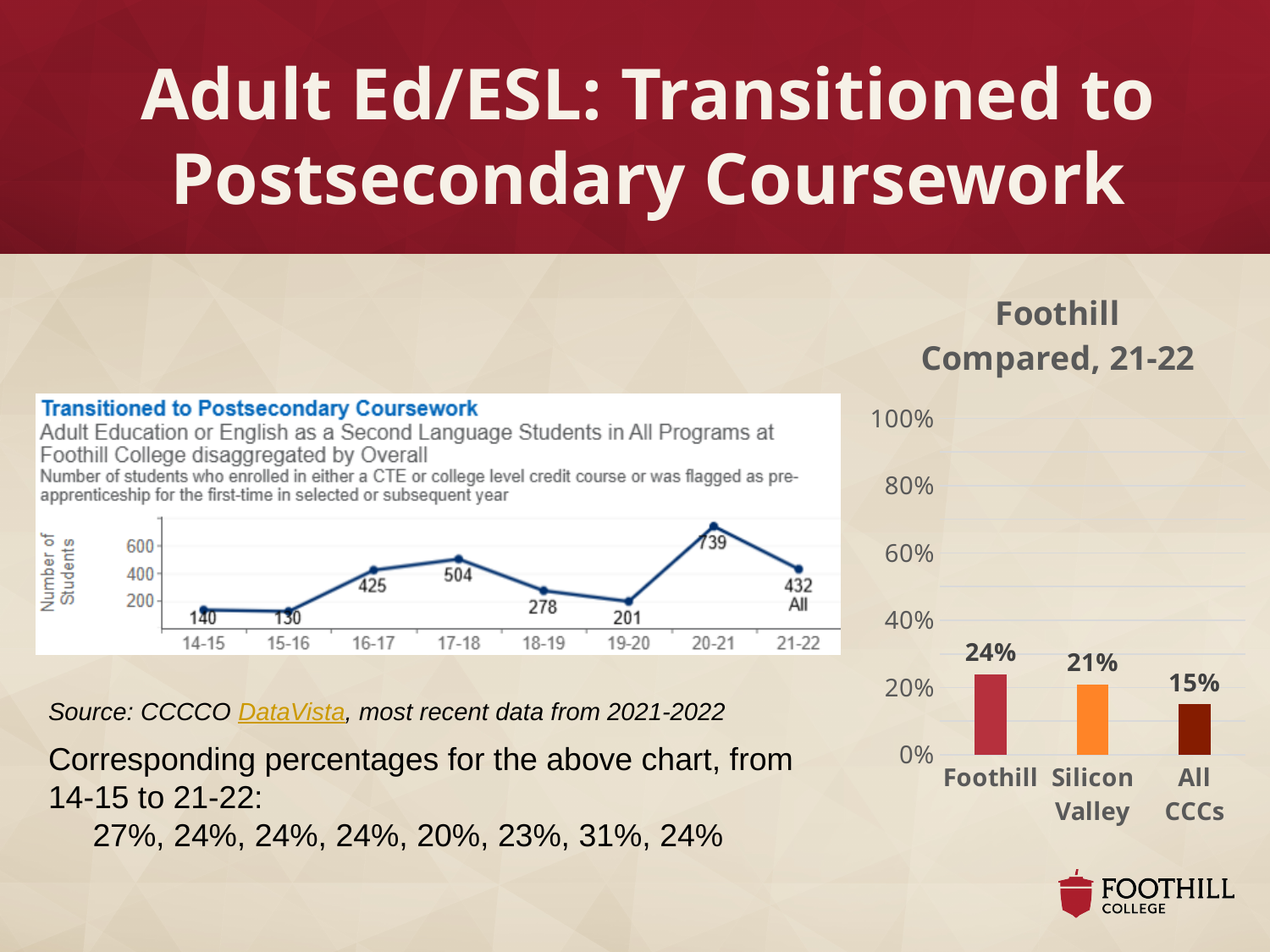
In the 'Foothill Compared, 21-22' chart, which is larger, Foothill or Silicon Valley? Foothill In the 'Transitioned to Postsecondary Coursework' line chart, what is the number of students for 17-18? 504 In the 'Transitioned to Postsecondary Coursework' line chart, which year has the lowest number of students? 15-16 In the 'Transitioned to Postsecondary Coursework' line chart, what is the difference in number of students between 20-21 and 21-22? 307 In the 'Transitioned to Postsecondary Coursework' line chart, what is the number of students for 20-21? 739 In the 'Foothill Compared, 21-22' chart, which category has the lowest value? All CCCs In the 'Transitioned to Postsecondary Coursework' line chart, does the number of students rise or fall from 18-19 to 19-20? fall In the 'Transitioned to Postsecondary Coursework' line chart, how many years are plotted? 8 In the 'Foothill Compared, 21-22' chart, what is the value for Silicon Valley? 21% In the 'Foothill Compared, 21-22' chart, what is the difference between Foothill and All CCCs? 9% What kind of chart is 'Foothill Compared, 21-22'? bar chart In the 'Transitioned to Postsecondary Coursework' line chart, which year has the highest number of students? 20-21